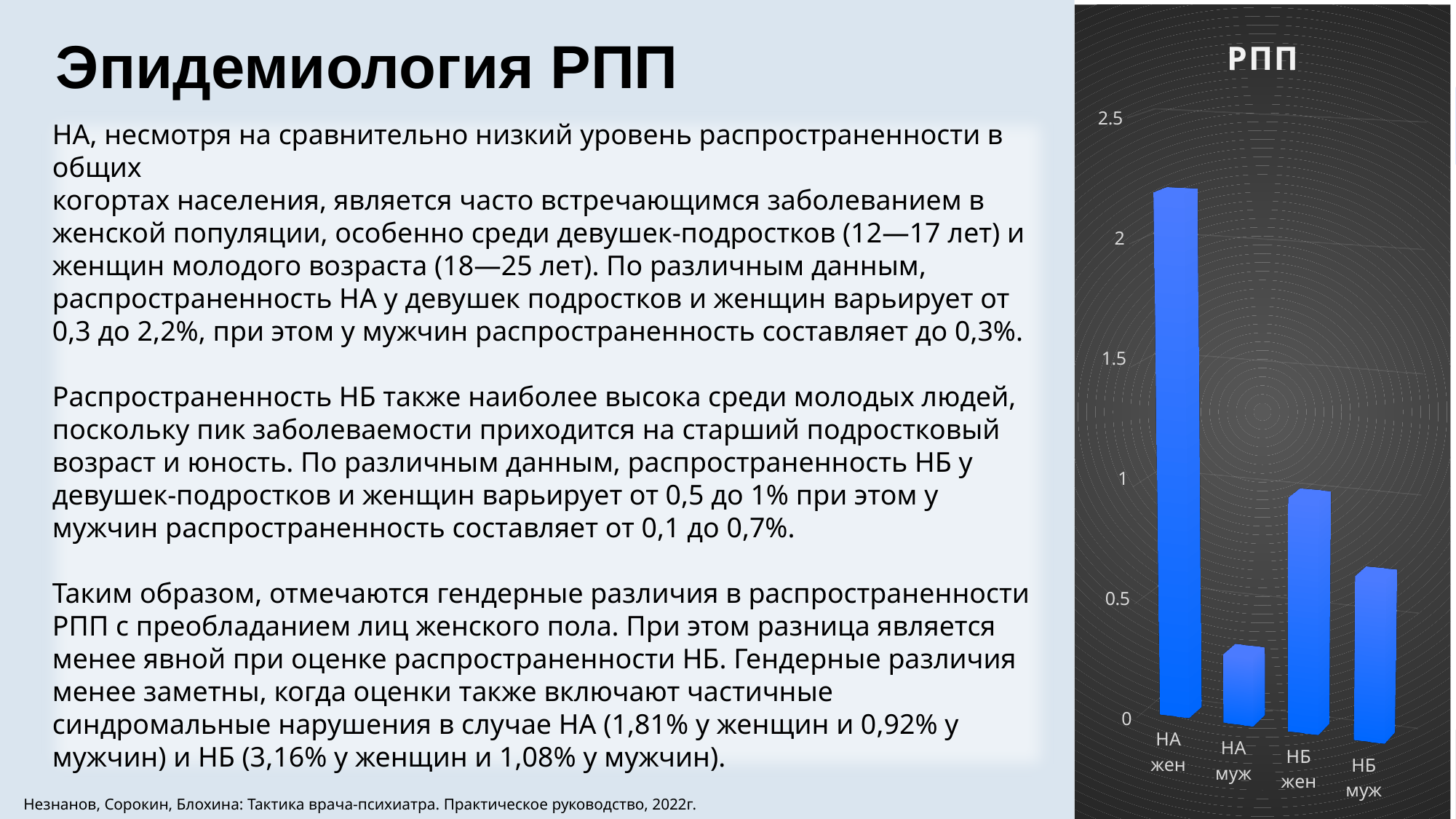
Is the value for НА жен greater or less than 2? greater What type of chart is shown on the slide? bar chart Which category has the lowest bar in the chart? НА муж Which is larger, the value for НА муж or the value for НБ муж? НБ муж Is the value for НА жен greater or less than 2.5? less Which is larger, the value for НБ жен or the value for НБ муж? НБ жен Is the value for НБ муж greater or less than 1? less What is the title of the chart? РПП Which category has the highest bar in the chart? НА жен How many categories are shown in the chart? 4